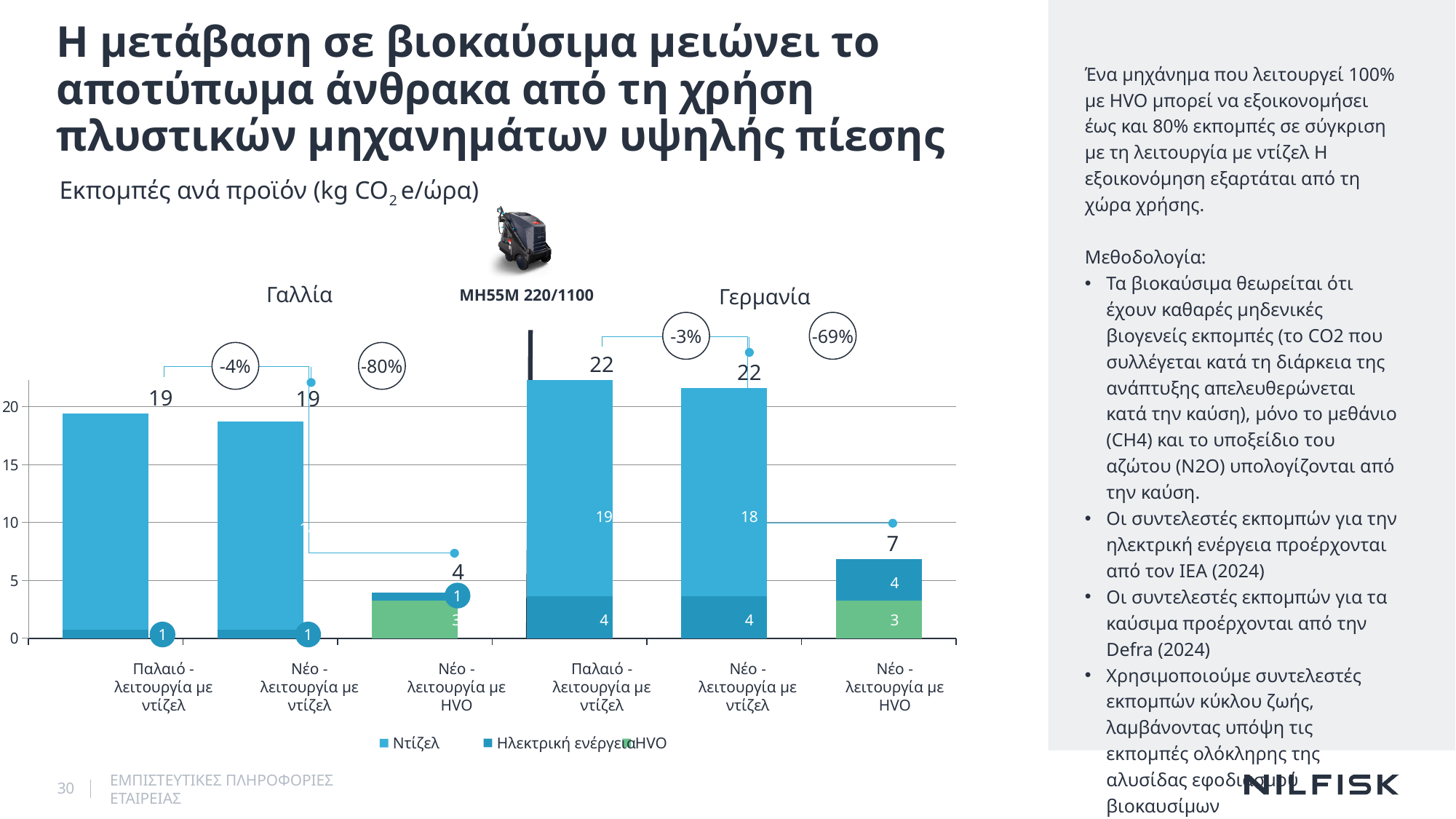
What is the total emissions value for the France 'Νέο - λειτουργία με HVO' bar? 4 Which bar has the lowest total emissions? Νέο - λειτουργία με HVO (Γαλλία) What type of chart is shown on the slide? stacked bar chart How many series does the chart legend list? 3 What is the Ντίζελ segment value for the Germany 'Νέο - λειτουργία με ντίζελ' bar? 18 What is the unit of emissions given in the chart subtitle? kg CO2 e/ώρα What is the difference between the Germany 'Νέο - λειτουργία με ντίζελ' total (22) and the Germany 'Νέο - λειτουργία με HVO' total (7)? 15 What is the Ηλεκτρική ενέργεια segment value for the Germany 'Νέο - λειτουργία με HVO' bar? 4 How many bars (categories) are plotted in the chart? 6 What percentage reduction is shown for switching to HVO in Germany? -69% What is the total emissions value for the Germany 'Παλαιό - λειτουργία με ντίζελ' bar? 22 Which is larger: the total for Germany 'Παλαιό - λειτουργία με ντίζελ' or France 'Παλαιό - λειτουργία με ντίζελ'? Germany 'Παλαιό - λειτουργία με ντίζελ'